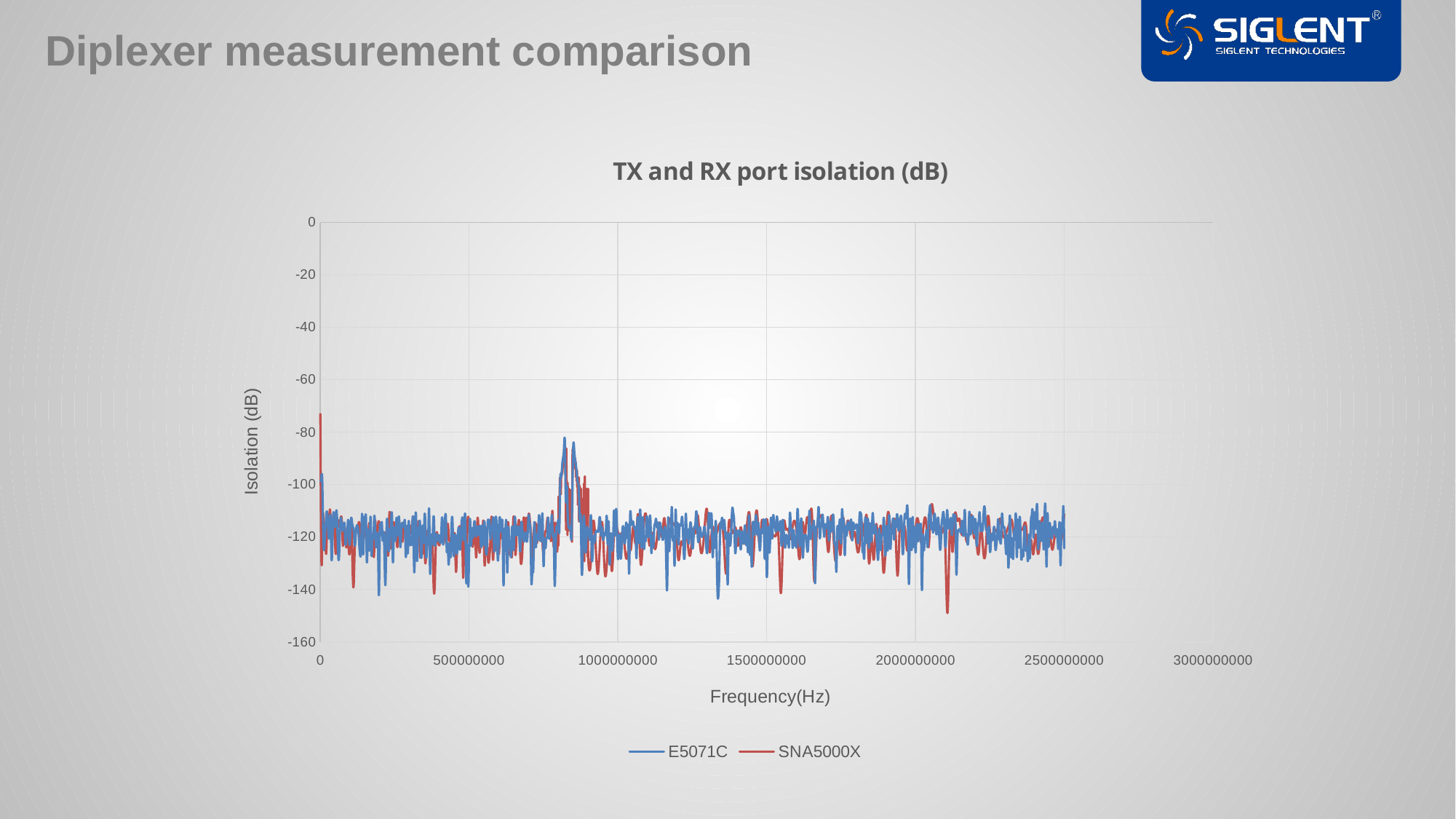
Which series has the lower minimum value, E5071C or SNA5000X? SNA5000X What are the names of the two series in the legend? E5071C and SNA5000X Is the value for E5071C at 1500000000 Hz greater or less than -100? less Is the value for SNA5000X at 500000000 Hz greater or less than -60? less How many series does the legend list? 2 Is the value for E5071C at its peak near 800000000 Hz greater or less than -100? greater What is the title of the chart? TX and RX port isolation (dB) What kind of chart is shown on the slide? line chart